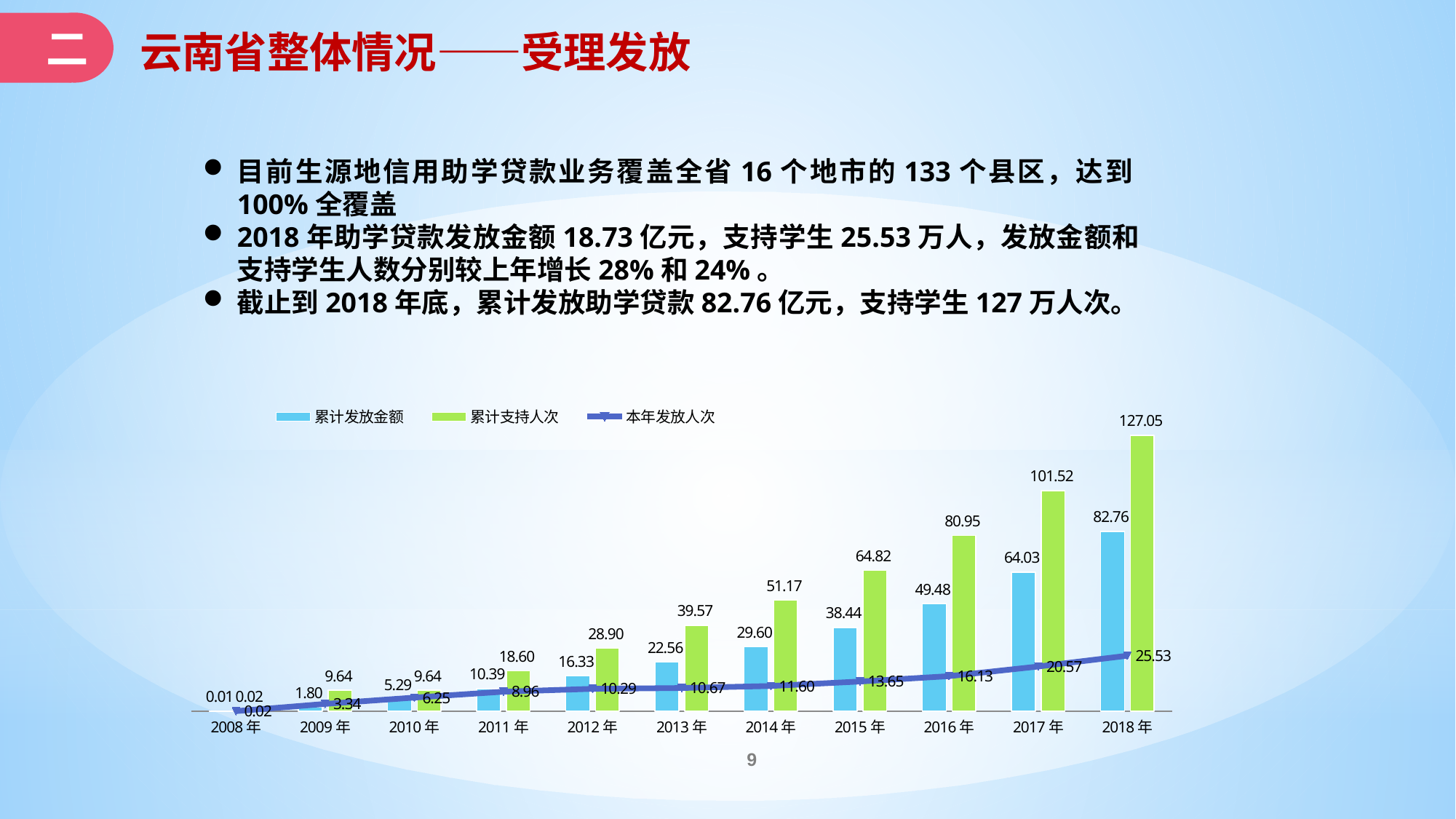
What is the value of 累计支持人次 for 2017年? 101.52 Which year has the lowest value of 累计发放金额? 2008年 Does the value of 本年发放人次 rise or fall from 2008年 to 2018年? Rise What is the value of 累计发放金额 for 2018年? 82.76 Which year has the highest value of 累计支持人次? 2018年 What kind of chart is this? Combined bar and line chart What is the value of 本年发放人次 for 2015年? 13.65 How many series does the legend list? 3 What is the difference between 累计支持人次 in 2018年 and 2017年? 25.53 How many years are shown on the x axis? 11 Which is larger in 2014年: 累计发放金额 or 累计支持人次? 累计支持人次 What is the value of 累计支持人次 for 2012年? 28.90